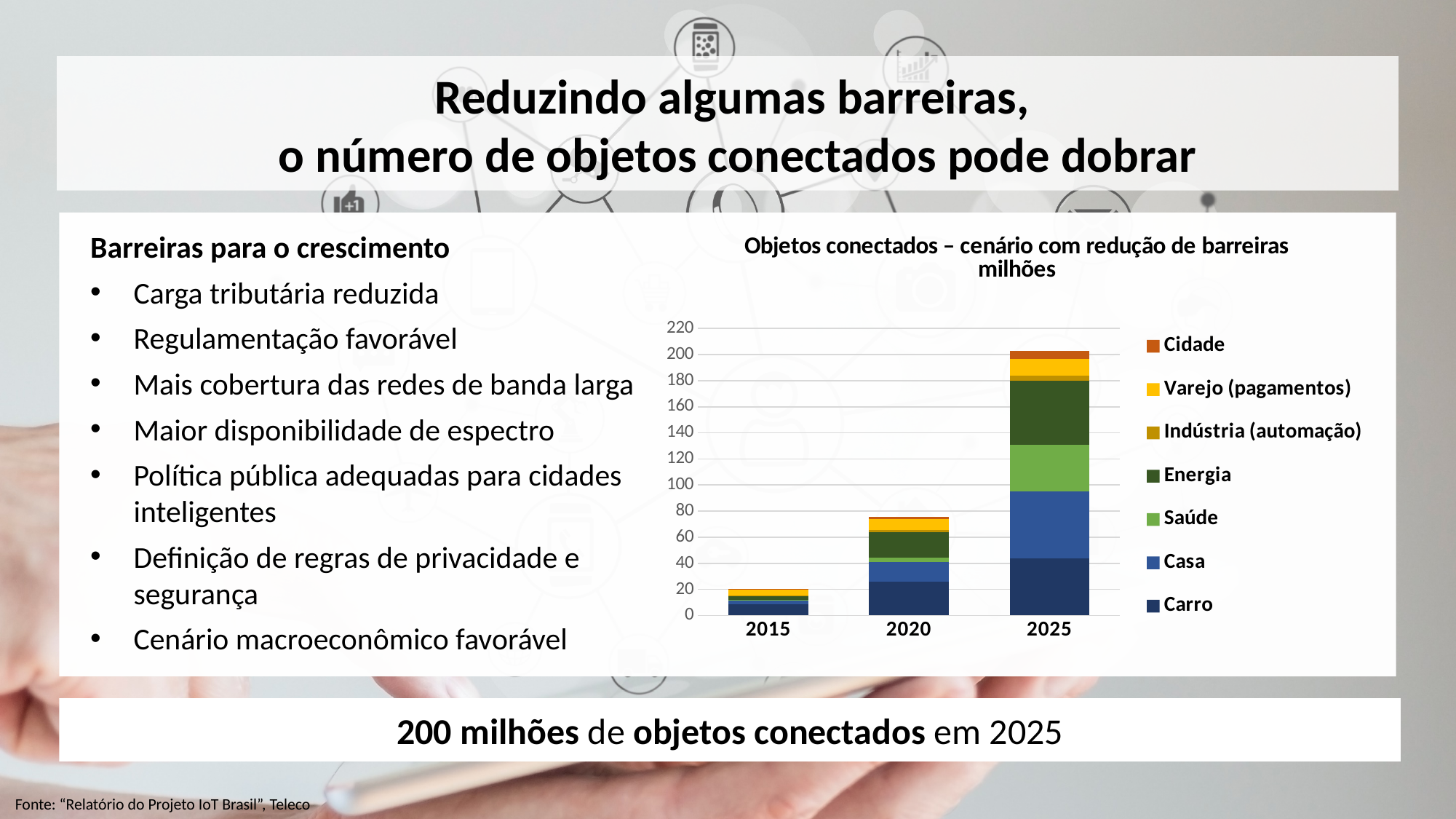
What kind of chart is shown on the slide? Stacked bar chart How many years (categories) are shown on the x axis of the chart? 3 Is the total stacked bar for 2015 greater or less than 40? less Is the total stacked bar for 2025 greater or less than 180? greater Is the total stacked bar for 2020 greater or less than 60? greater Which year has the shortest stacked bar in the chart? 2015 What unit is stated under the chart title? milhões Which year has a larger total of connected objects, 2015 or 2020? 2020 How many series does the chart's legend list? 7 Which year has the tallest stacked bar in the chart? 2025 Do the total values rise or fall from 2015 to 2025 in the chart? Rise